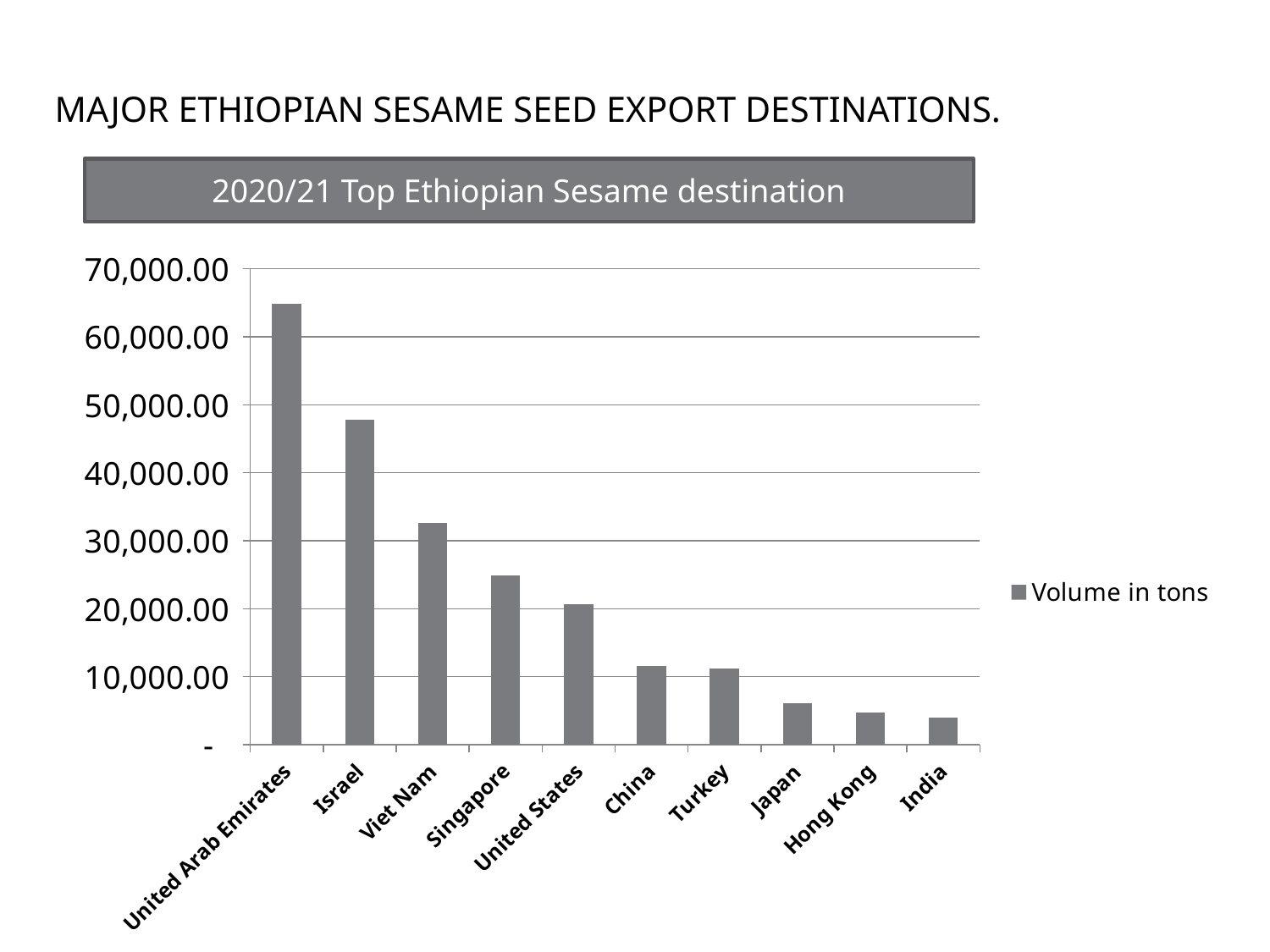
What kind of chart is shown on the slide? Bar chart How many series does the legend list? 1 What is the title of the chart? 2020/21 Top Ethiopian Sesame destination Which destination has the lowest volume in tons? India Which destination has the highest volume in tons? United Arab Emirates Which has a larger volume in tons, Singapore or United States? Singapore Is the value for Japan greater or less than 10,000.00? less How many destination countries are shown on the chart? 10 Is the value for United Arab Emirates greater or less than 60,000.00? greater Is the value for Viet Nam greater or less than 30,000.00? greater What is the name of the series shown in the legend? Volume in tons